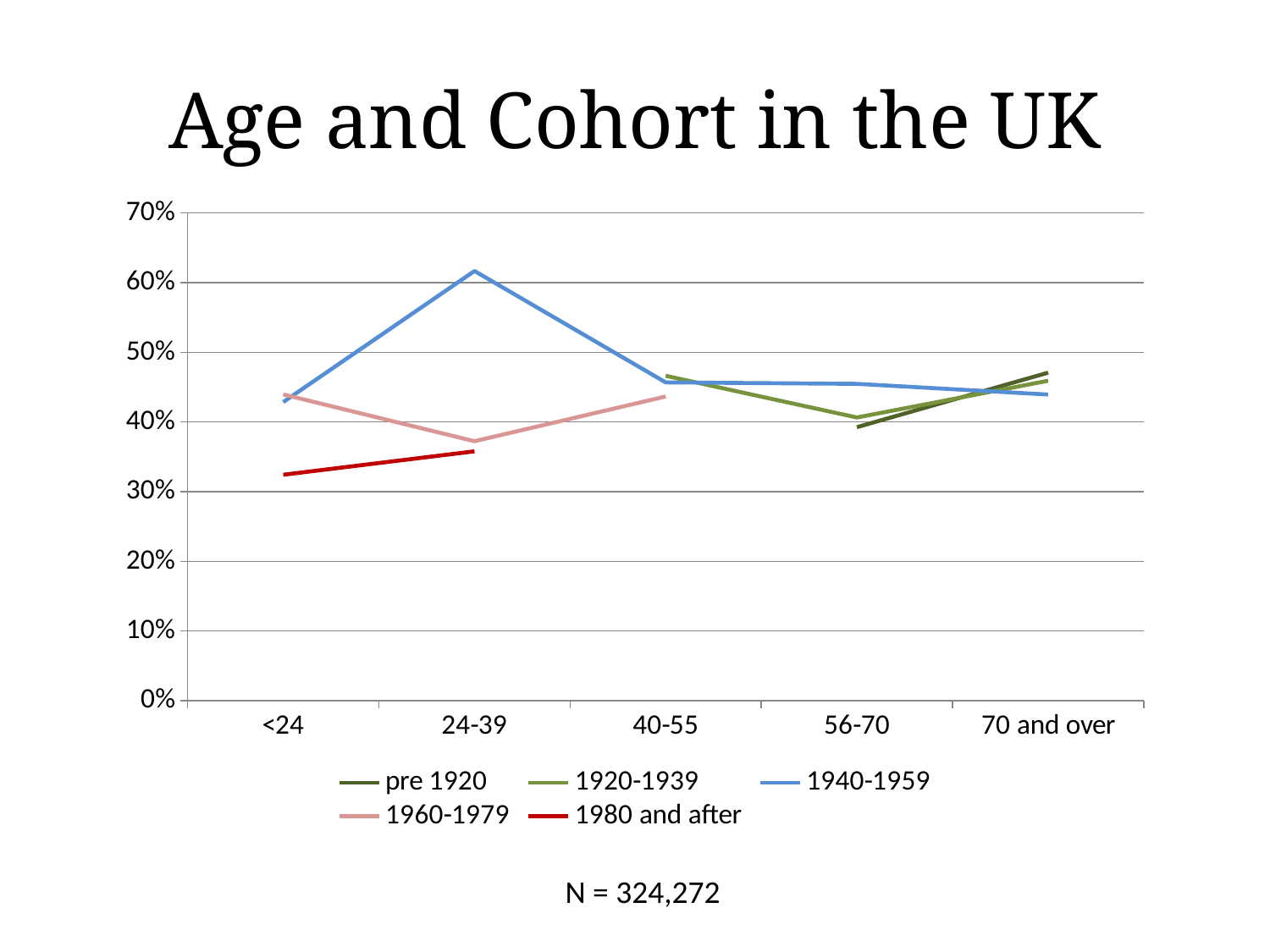
How many age groups are shown on the x axis? 5 At age 24-39, which cohort has the larger value, 1940-1959 or 1960-1979? 1940-1959 Does the line for the 1980 and after cohort rise or fall from <24 to 24-39? rise Does the line for the 1940-1959 cohort rise or fall from 24-39 to 70 and over? fall Is the value for the 1980 and after cohort at age <24 greater or less than 40%? less How many series does the legend list? 5 For the 1960-1979 cohort, which age group has the lowest value? 24-39 What is the title of the slide? Age and Cohort in the UK What kind of chart is shown on the slide? line chart Is the value for the 1960-1979 cohort at age 24-39 greater or less than 40%? less For the 1940-1959 cohort, which age group has the highest value? 24-39 Is the value for the 1940-1959 cohort at age 24-39 greater or less than 60%? greater